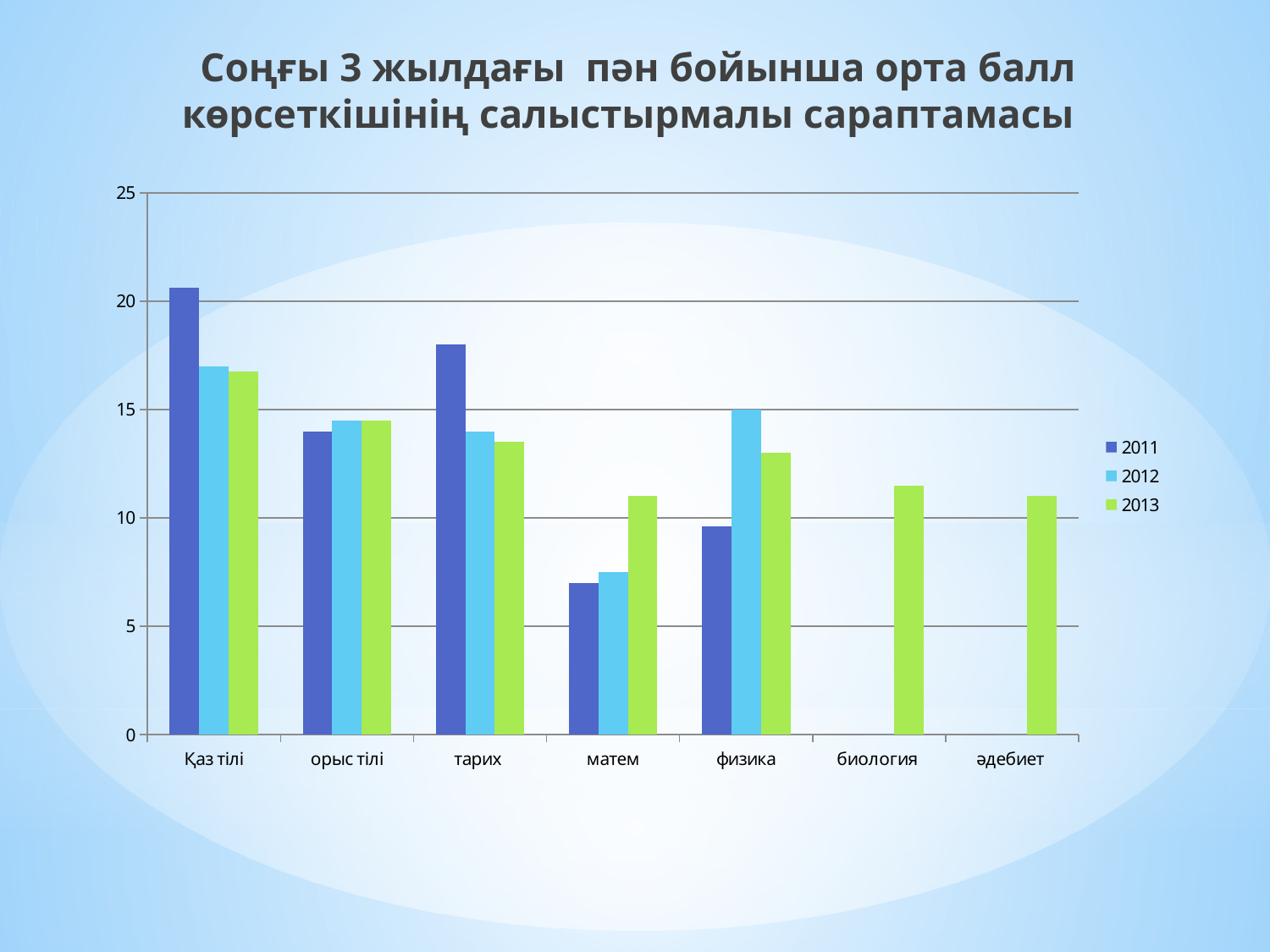
Which subject has the highest 2012 bar? Қаз тілі Is the 2011 value for Қаз тілі greater or less than 20? greater How many series does the legend list? 3 Which subject has the lowest 2011 bar? матем Is the 2013 value for биология greater or less than 10? greater How many subject categories are shown on the x axis? 7 For матем, which year has the larger value, 2011 or 2013? 2013 For физика, which year has the larger value, 2011 or 2012? 2012 Which years are listed in the legend? 2011, 2012, 2013 Is the 2011 value for матем greater or less than 10? less Which subject has the highest 2011 bar? Қаз тілі What kind of chart is shown on the slide? bar chart